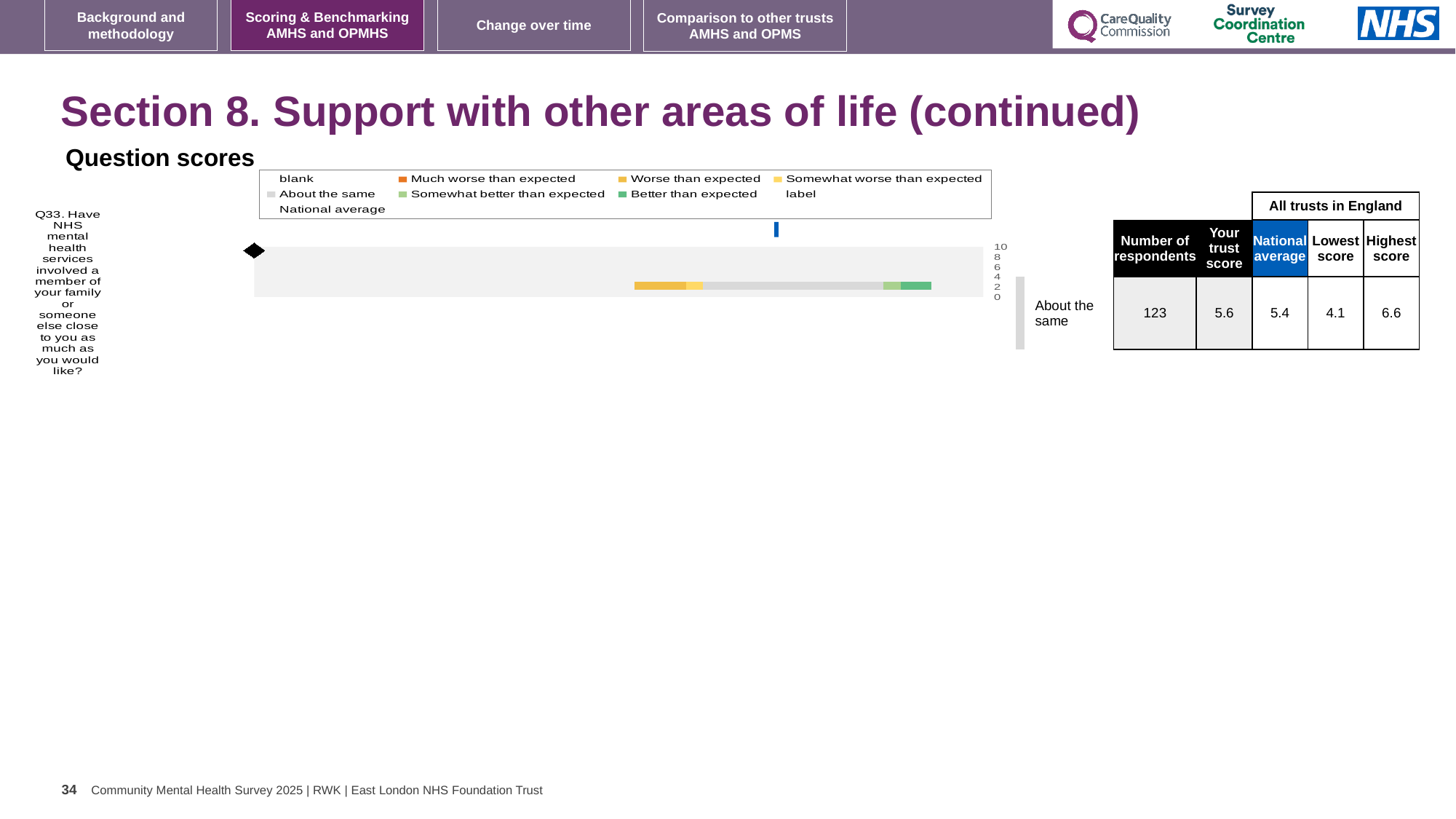
What benchmark category label is shown next to the bar for Q33? About the same Which survey question is plotted in the Question scores chart? Q33 In the table beside the chart, what is the number of respondents for Q33? 123 What colour does the legend use for 'Better than expected'? green In the table beside the chart, what is the Highest score among all trusts in England for Q33? 6.6 How many survey questions are plotted in the Question scores chart? 1 In the table beside the chart, what is the 'Your trust score' for Q33? 5.6 For Q33, is the trust score or the National average larger? trust score In the table beside the chart, what is the National average for Q33? 5.4 In the table beside the chart, what is the Lowest score among all trusts in England for Q33? 4.1 What kind of chart is shown under 'Question scores'? bar chart What is the highest tick value shown on the chart's axis? 10